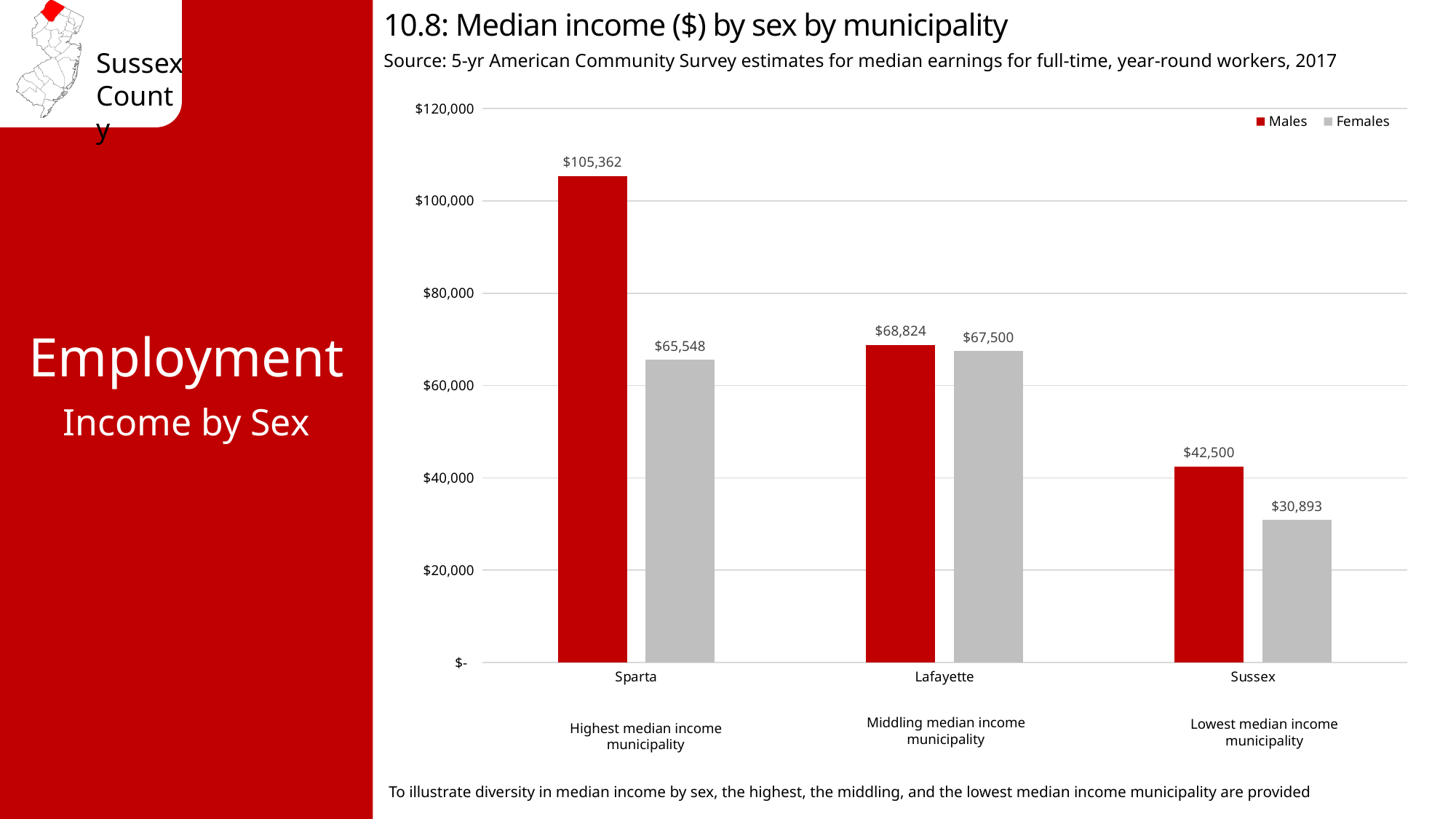
How many municipalities are shown on the chart? 3 What kind of chart is shown on the slide? bar chart Is the male median income in Sussex greater or less than $40,000? greater What is the median income for females in Lafayette? $67,500 Which municipality has the lowest median income for females? Sussex What is the difference between male and female median income in Sparta? $39,814 What is the difference between male and female median income in Sussex? $11,607 What is the median income for females in Sussex? $30,893 Which municipality has the highest median income for males? Sparta What is the median income for males in Sparta? $105,362 How many series does the legend list? 2 Which is larger, the female median income in Sparta or the female median income in Lafayette? Lafayette